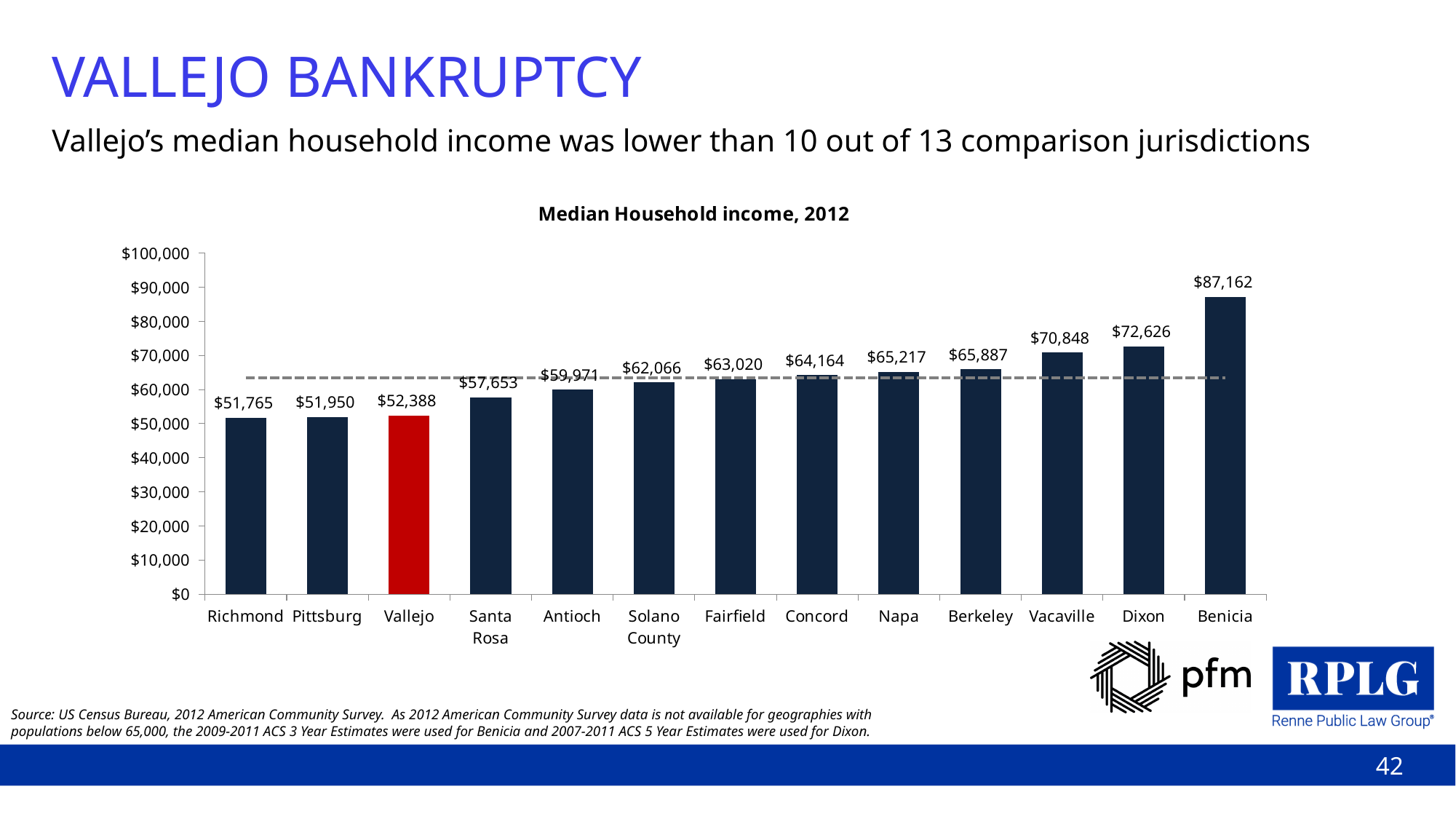
What is the median household income shown for Vallejo? $52,388 What kind of chart is used to show median household income? Bar chart What is the difference between the median household income of Dixon and Vacaville? $1,778 What is the median household income shown for Solano County? $62,066 What is the median household income shown for Benicia? $87,162 Is the value for Vacaville greater or less than $60,000? greater Which bar in the chart is coloured red? Vallejo Which has a higher median household income, Napa or Antioch? Napa How many jurisdictions are shown in the chart? 13 Which jurisdiction has the highest median household income in the chart? Benicia Which jurisdiction has the lowest median household income in the chart? Richmond What is the difference between the median household income of Benicia and Vallejo? $34,774